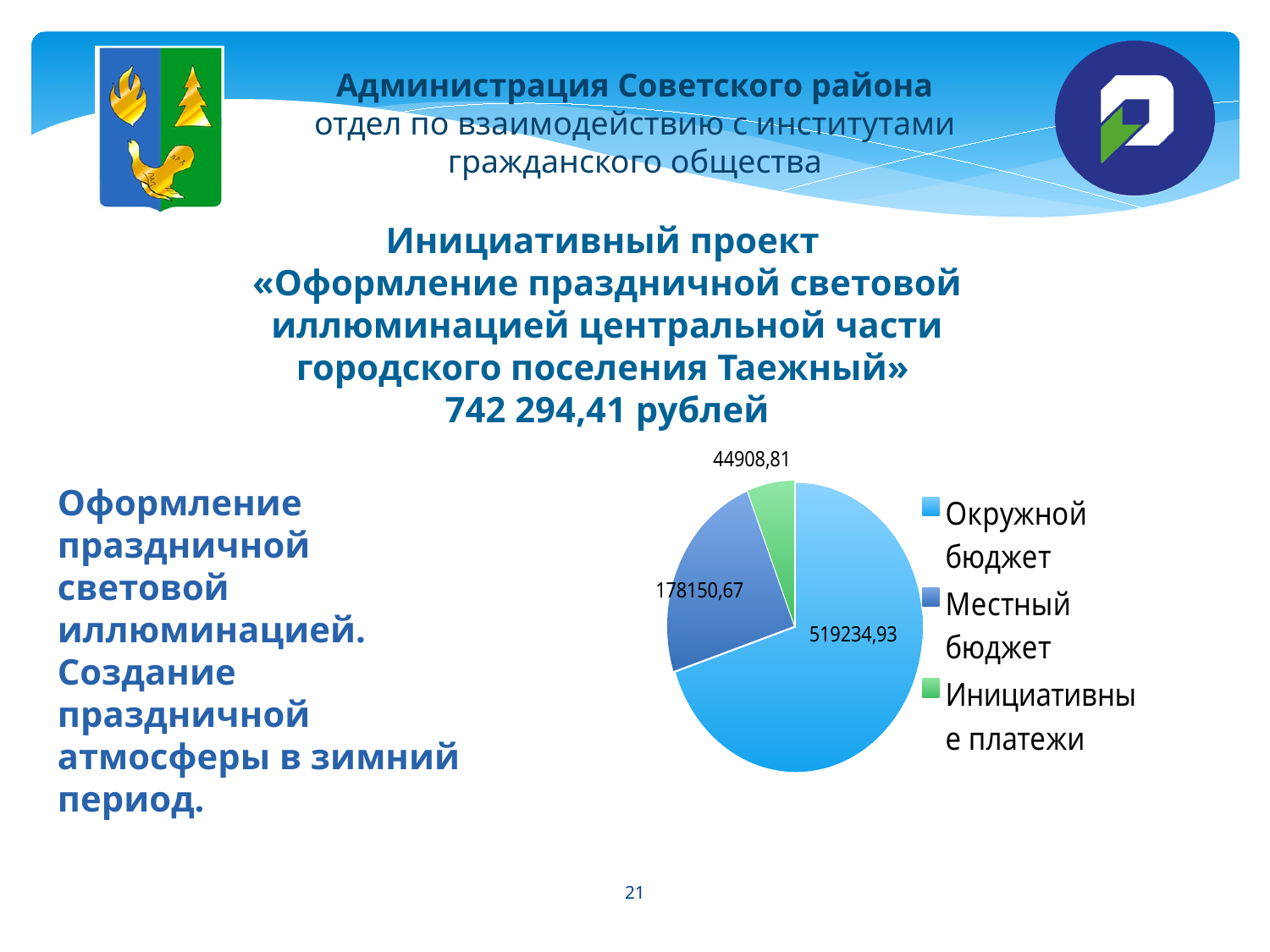
How many slices does the pie chart have? 3 Which is larger: Местный бюджет or Инициативные платежи? Местный бюджет What is the total of all three slices in the pie chart? 742294,41 What value is shown for Местный бюджет in the pie chart? 178150,67 What colour is the slice for Инициативные платежи in the pie chart? Green What value is shown for Окружной бюджет in the pie chart? 519234,93 What is the difference between the values for Местный бюджет and Инициативные платежи? 133241,86 What type of chart is shown on the slide? Pie chart What is the difference between the values for Окружной бюджет and Местный бюджет? 341084,26 What value is shown for Инициативные платежи in the pie chart? 44908,81 Which category has the smallest slice in the pie chart? Инициативные платежи Which category has the largest slice in the pie chart? Окружной бюджет